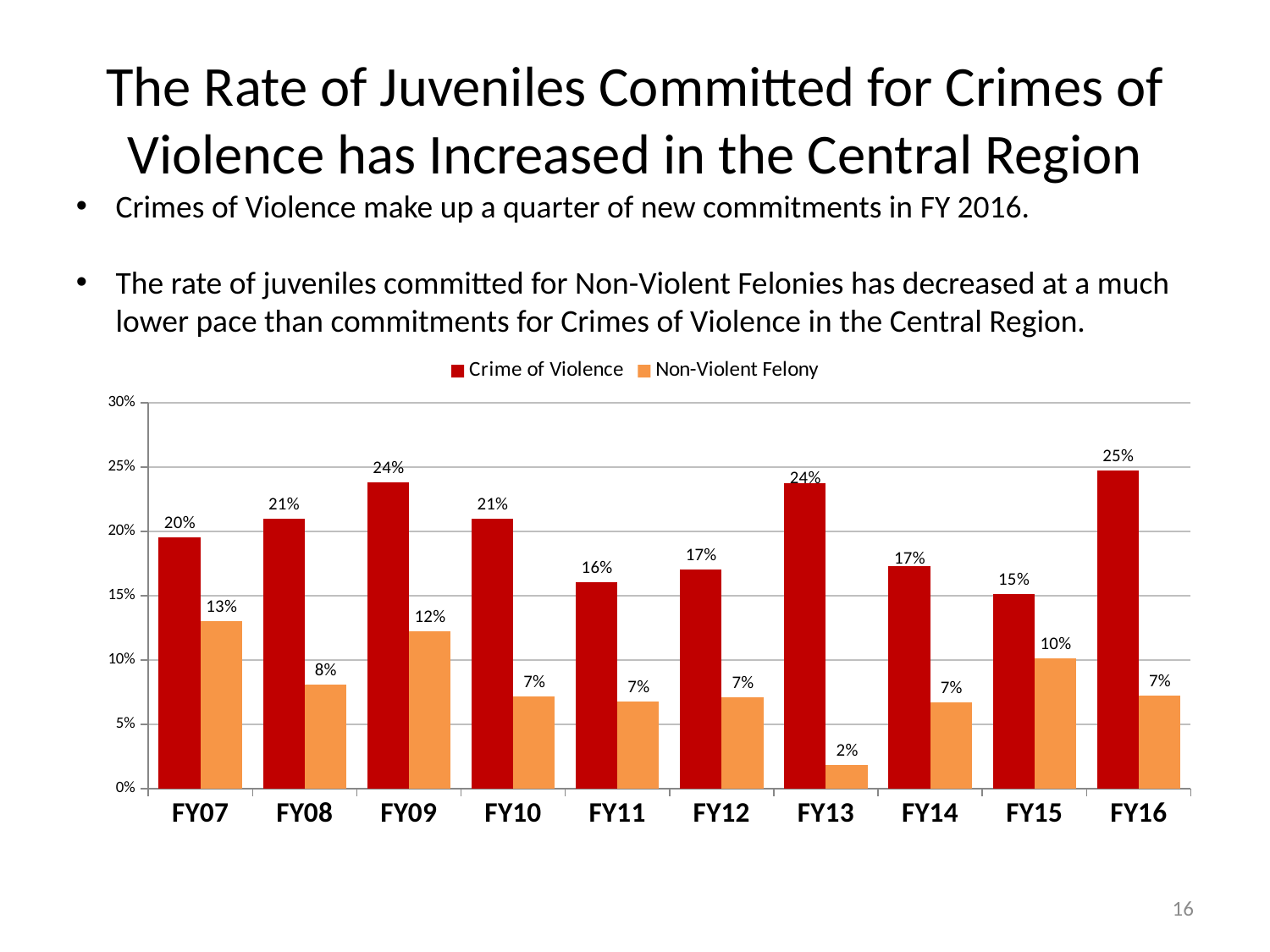
What kind of chart is shown on the slide? Bar chart What is the Non-Violent Felony value for FY15? 10% How many series does the legend list? 2 Which fiscal year has the highest Crime of Violence value? FY16 What is the difference between the Crime of Violence and Non-Violent Felony values in FY16? 18 percentage points Which fiscal year has the lowest Non-Violent Felony value? FY13 What is the Crime of Violence value for FY16? 25% What is the Crime of Violence value for FY11? 16% Which is larger in FY09: the Crime of Violence value or the Non-Violent Felony value? Crime of Violence What is the Non-Violent Felony value for FY13? 2% Which fiscal year has the highest Non-Violent Felony value? FY07 How many fiscal years are shown on the x axis? 10